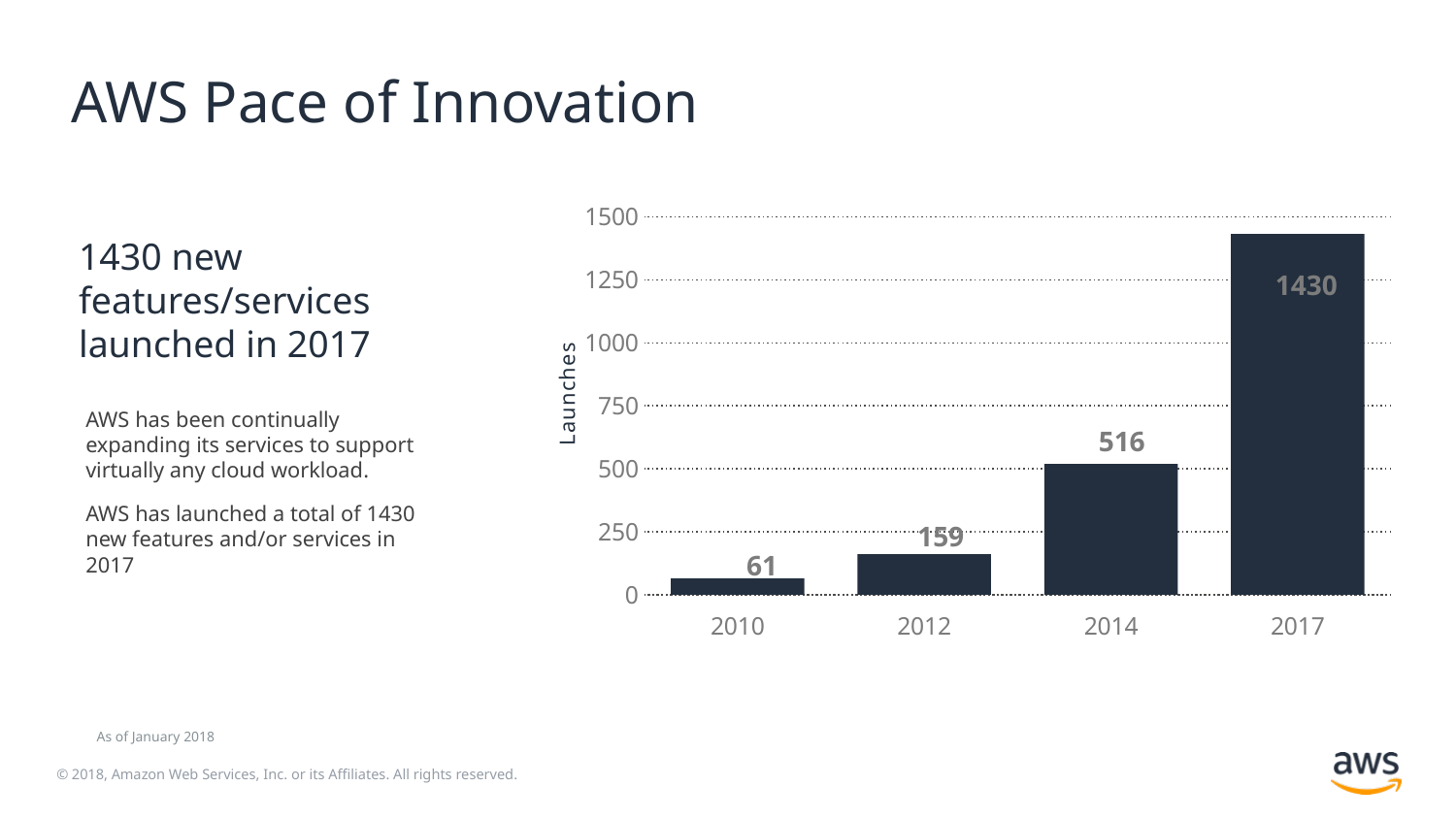
How many launches are shown for 2014? 516 What kind of chart is shown on the slide? Bar chart Which year has more launches, 2012 or 2014? 2014 What is the value for 2012 in the chart? 159 Which year has the lowest number of launches? 2010 How many years are shown on the x axis of the chart? 4 What is the difference in launches between 2017 and 2014? 914 Which year has the highest number of launches? 2017 How many launches does the chart show for 2010? 61 Do the launch values rise or fall from 2010 to 2017? Rise What is the difference in launches between 2012 and 2010? 98 What is the value for 2017 in the chart? 1430